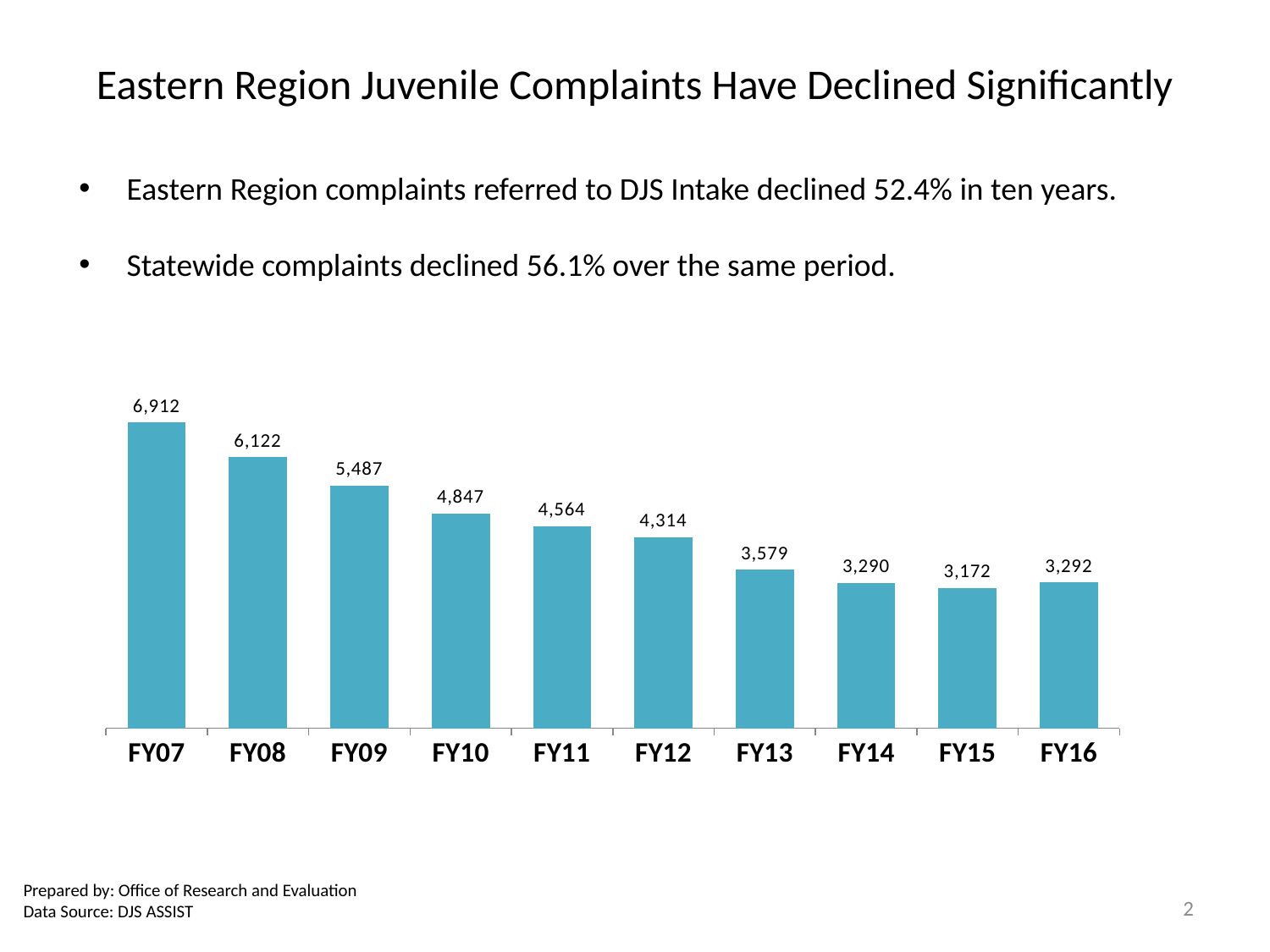
Which is larger, the value for FY10 or the value for FY11? FY10 What is the difference between the values for FY07 and FY16? 3,620 What kind of chart is shown on the slide? bar chart Do the values generally rise or fall from FY07 to FY16? fall Which fiscal year has the lowest value? FY15 What is the value for FY16? 3,292 What is the difference between the values for FY08 and FY09? 635 How many fiscal years are shown on the chart? 10 What colour are the bars in the chart? blue What is the value for FY12? 4,314 What is the value for FY07? 6,912 Which fiscal year has the highest value? FY07